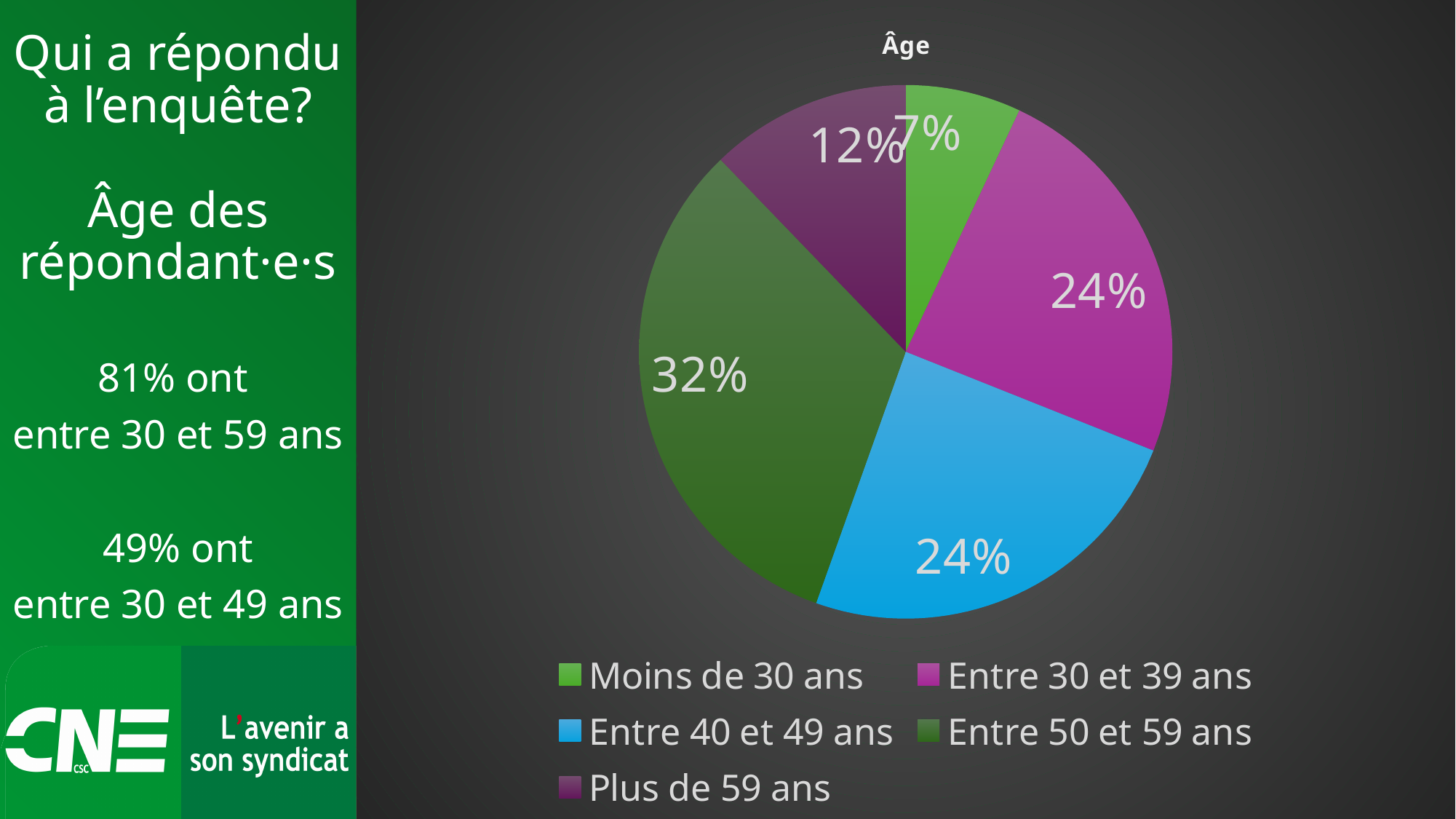
What percentage of respondents are in the 'Entre 30 et 39 ans' category? 24% What is the difference in percentage points between 'Entre 50 et 59 ans' and 'Plus de 59 ans'? 20 How many age categories does the pie chart show? 5 What is the title of the chart? Âge Which age category has the smallest share of the pie? Moins de 30 ans Which is larger: the share for 'Plus de 59 ans' or the share for 'Moins de 30 ans'? Plus de 59 ans Which age category has the largest share of the pie? Entre 50 et 59 ans What kind of chart is shown on the slide? Pie chart What percentage of respondents are 'Plus de 59 ans'? 12% What percentage of respondents are 'Moins de 30 ans'? 7% What colour is the slice for 'Entre 40 et 49 ans'? Blue What percentage of respondents are in the 'Entre 50 et 59 ans' category? 32%